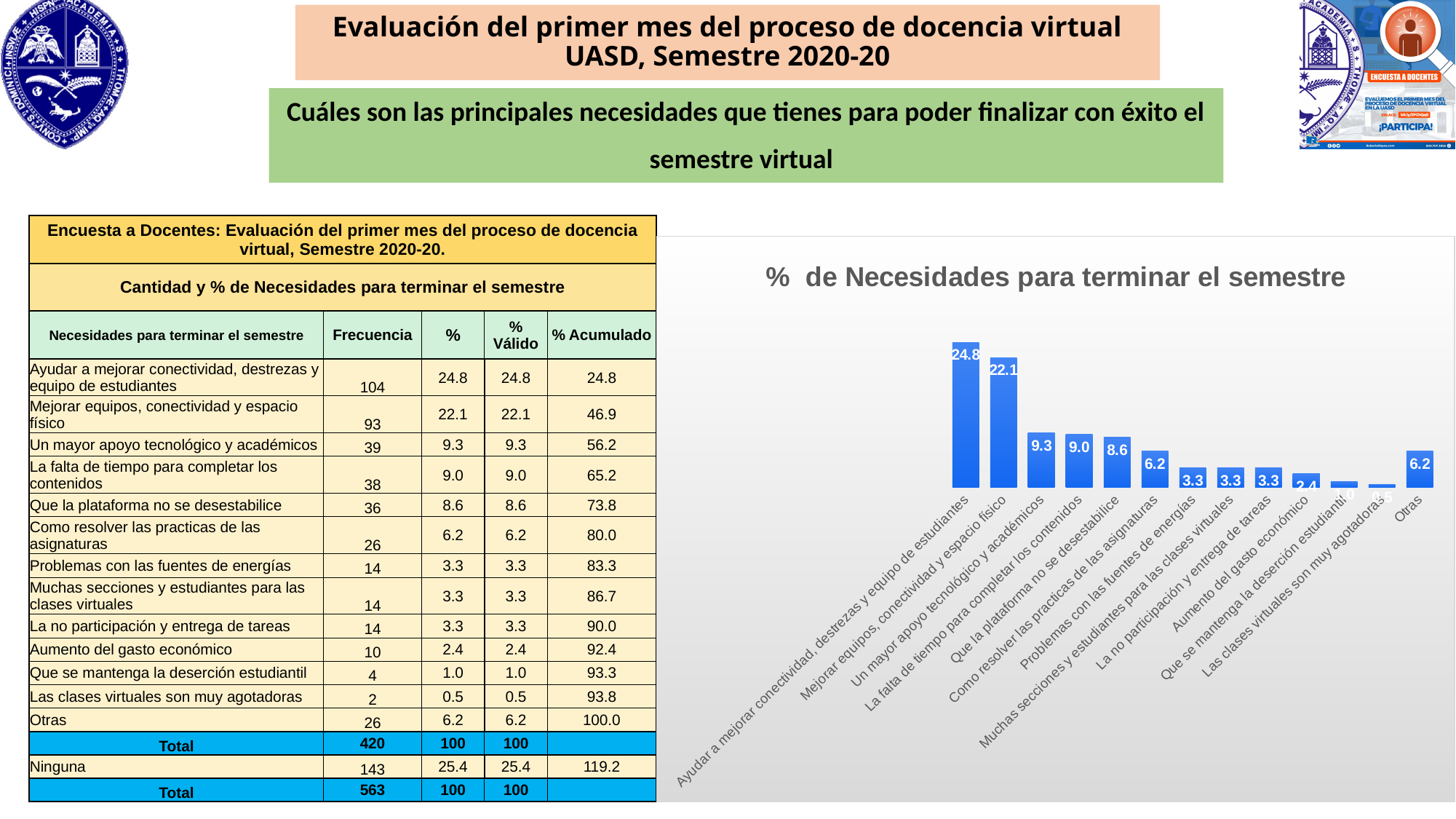
What is the difference between the values for "Ayudar a mejorar conectividad, destrezas y equipo de estudiantes" and "Mejorar equipos, conectividad y espacio físico"? 2.7 What is the value for "Que la plataforma no se desestabilice" in the chart? 8.6 What is the value for "Mejorar equipos, conectividad y espacio físico" in the chart? 22.1 Which category has the lowest value in the chart? Las clases virtuales son muy agotadoras What is the title of the chart? % de Necesidades para terminar el semestre Which category has the highest value in the chart? Ayudar a mejorar conectividad, destrezas y equipo de estudiantes Which is larger: the value for "Un mayor apoyo tecnológico y académicos" or the value for "La falta de tiempo para completar los contenidos"? Un mayor apoyo tecnológico y académicos What is the value for "Aumento del gasto económico" in the chart? 2.4 How many categories (bars) does the chart show? 13 What is the value for "Otras" in the chart? 6.2 What kind of chart is shown on the slide? bar chart What is the value for "Ayudar a mejorar conectividad, destrezas y equipo de estudiantes" in the chart? 24.8